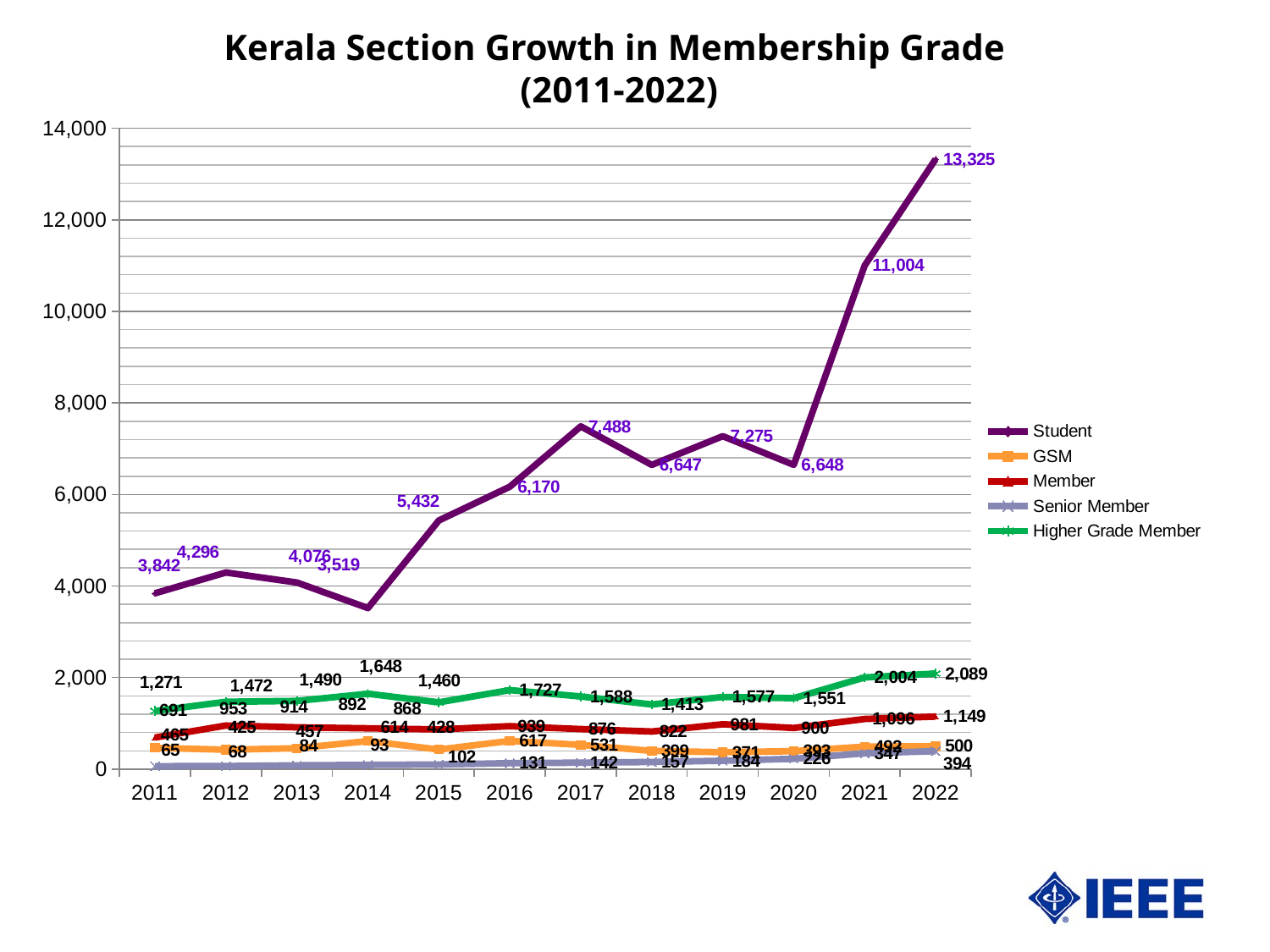
What kind of chart is shown on the slide? Line chart What is the difference between the Student values for 2022 and 2021? 2,321 In which year is the Student series at its highest? 2022 What is the Student value for 2022? 13,325 Does the Senior Member series rise or fall from 2011 to 2022? Rises Is the Student value for 2021 greater or less than 10,000? greater What is the Senior Member value for 2011? 65 What is the Higher Grade Member value for 2022? 2,089 Which year has the larger Student value, 2017 or 2019? 2017 How many years are plotted along the x axis? 12 How many series does the legend list? 5 In which year is the Student series at its lowest? 2014